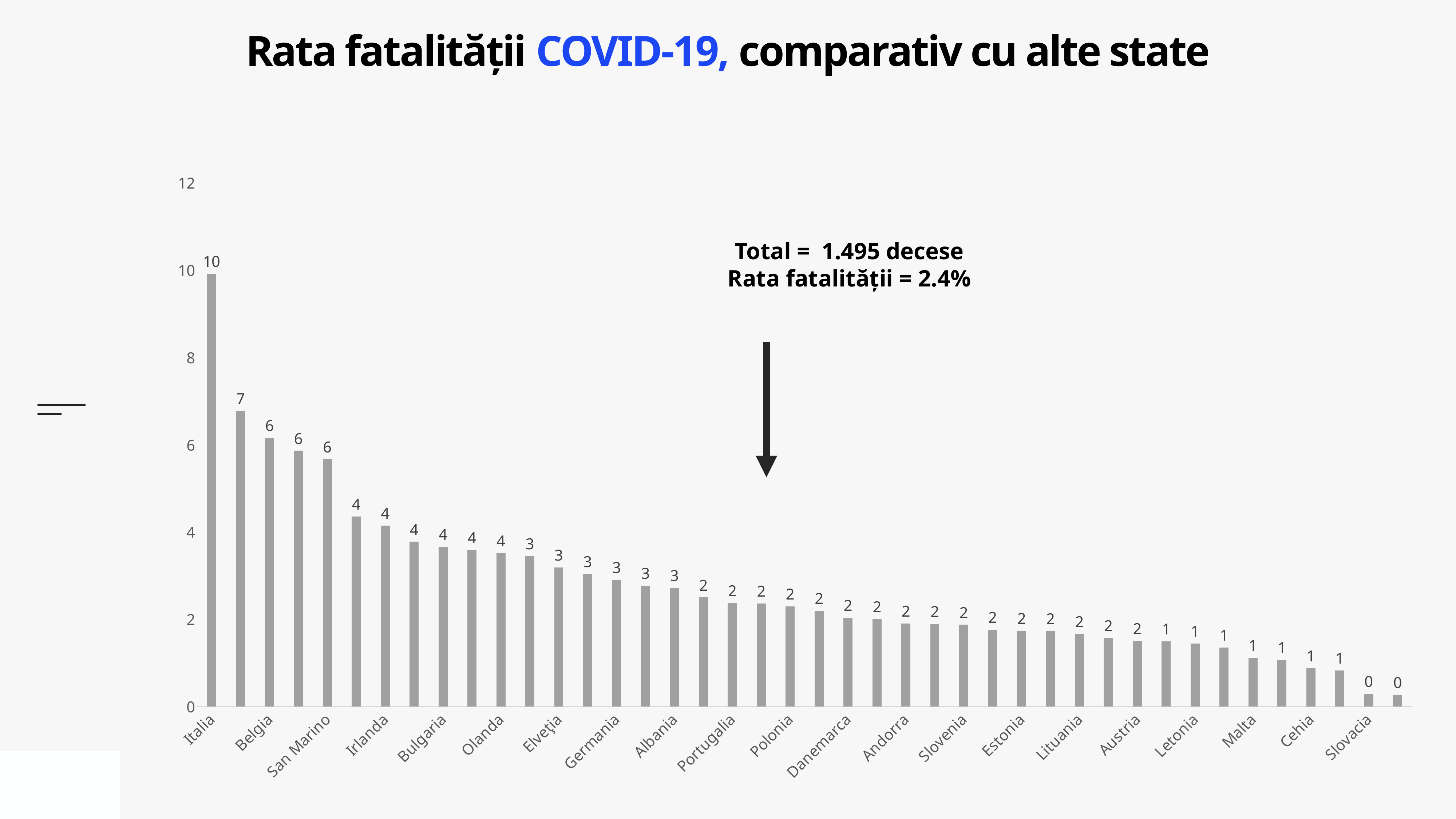
What type of chart is shown on the slide? bar chart What is the value shown for Slovacia? 0 What is the value shown for Italia? 10 What is the value shown for Irlanda? 4 What is the value shown for Belgia? 6 Which is larger, the value for Italia or the value for San Marino? Italia Which country has the highest fatality rate in the chart? Italia What fatality rate is stated in the text annotation above the chart? 2.4% Do the values rise or fall from left to right along the x axis? fall What is the difference between the values for Italia and Belgia? 4 What is the value shown for Germania? 3 Is the value for Belgia greater or less than 4? greater